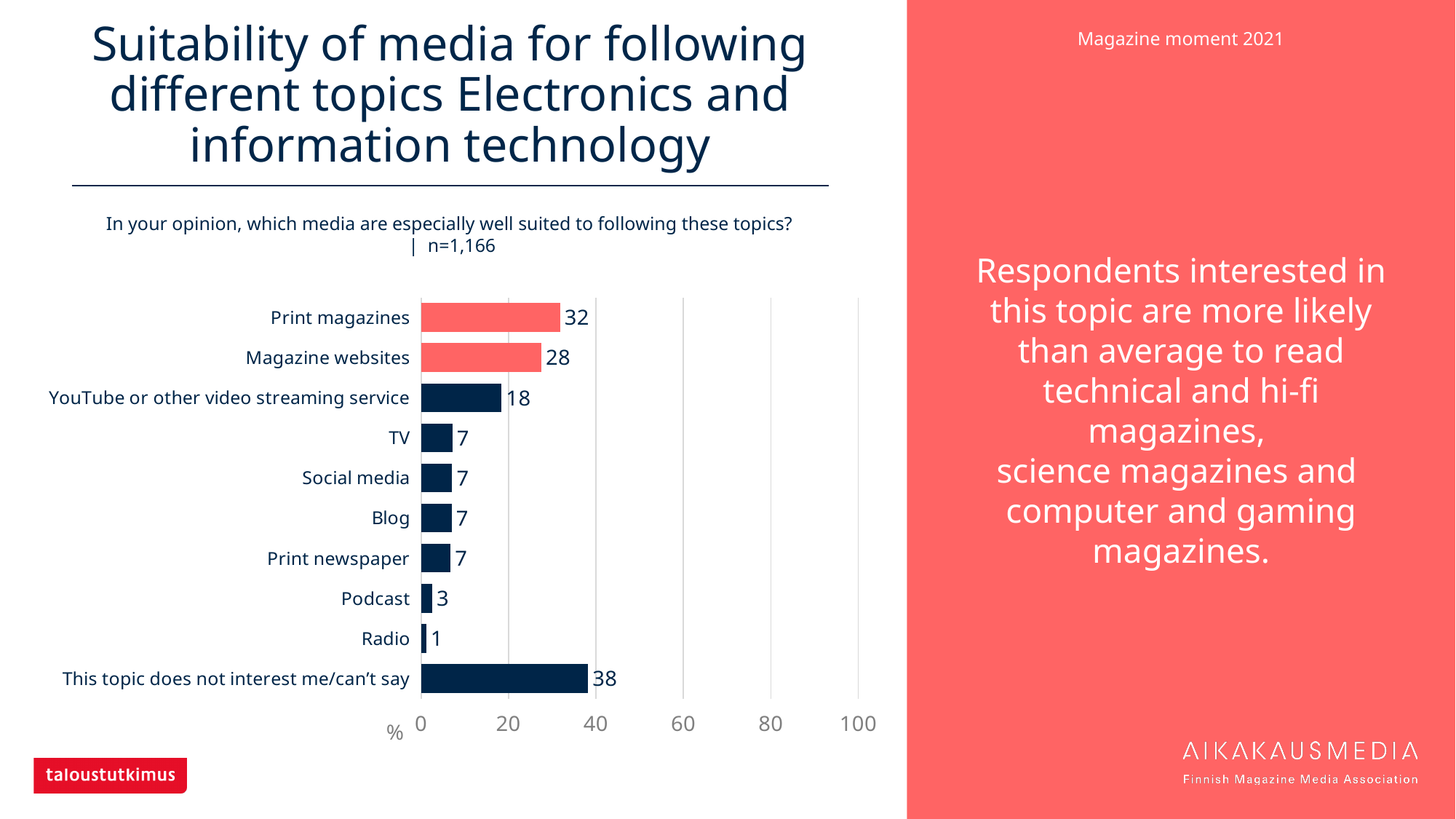
Is the value for This topic does not interest me/can't say greater or less than 20? greater Which category has the highest value? This topic does not interest me/can't say What is the difference between the values for Print magazines and Magazine websites? 4 What is the sample size (n) stated below the question text? n=1,166 What is the value for Print magazines? 32 Which is larger, the value for YouTube or other video streaming service or the value for TV? YouTube or other video streaming service What is the value for Magazine websites? 28 What is the value for Podcast? 3 Which category has the lowest value? Radio How many categories are shown in the chart? 10 What is the value for YouTube or other video streaming service? 18 What kind of chart is shown on the slide? bar chart